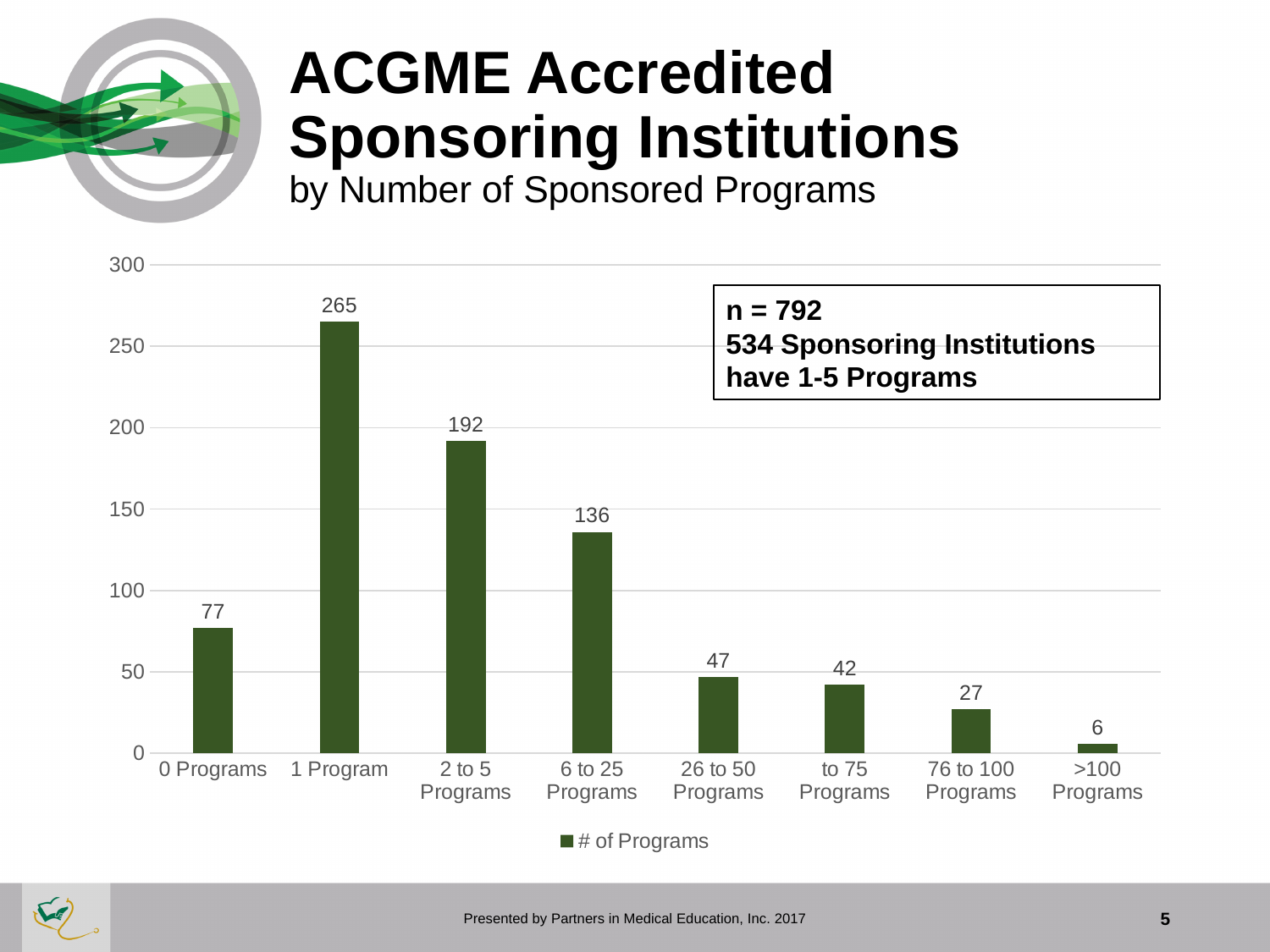
How many categories are shown on the x axis? 8 How many series does the legend list? 1 Is the value for 2 to 5 Programs greater or less than 150? greater Which is larger, the value for 0 Programs or the value for 26 to 50 Programs? 0 Programs What is the value for >100 Programs? 6 What is the legend entry for the series? # of Programs What kind of chart is shown on the slide? bar chart What is the value for 1 Program? 265 Which category has the highest value? 1 Program Which category has the lowest value? >100 Programs What is the difference between the values for 1 Program and 2 to 5 Programs? 73 What is the value for 6 to 25 Programs? 136